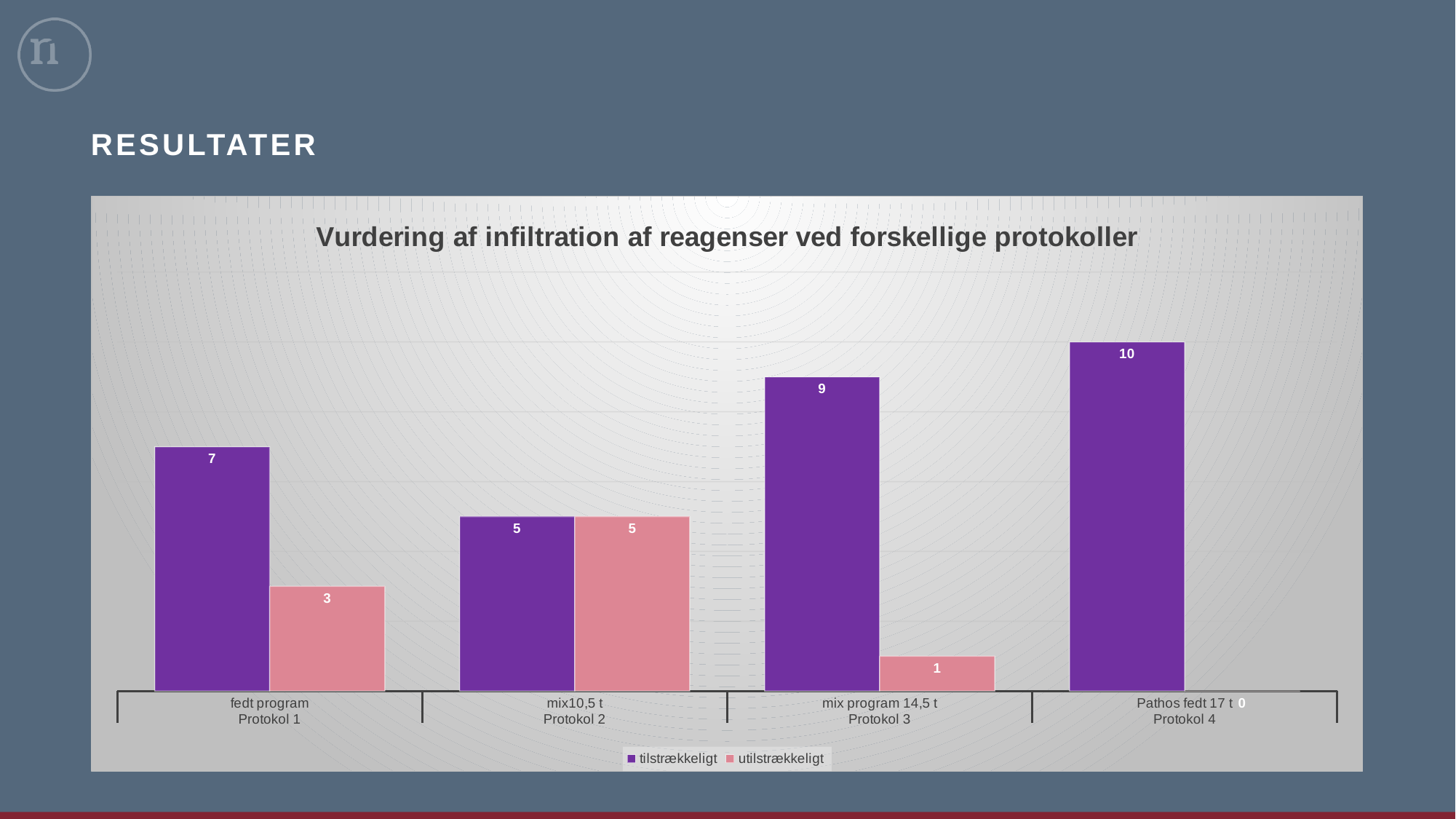
What is the value of utilstrækkeligt for Protokol 3 (mix program 14,5 t)? 1 What is the total of tilstrækkeligt and utilstrækkeligt for Protokol 2? 10 How many series does the legend list? 2 How many protocols are shown on the x axis? 4 What is the difference between the tilstrækkeligt and utilstrækkeligt values for Protokol 1? 4 What is the title of the chart? Vurdering af infiltration af reagenser ved forskellige protokoller Which protocol has the highest tilstrækkeligt value? Protokol 4 (Pathos fedt 17 t) Which protocol has the lowest tilstrækkeligt value? Protokol 2 (mix10,5 t) What kind of chart is shown? bar chart What is the value of utilstrækkeligt for Protokol 4 (Pathos fedt 17 t)? 0 What is the value of tilstrækkeligt for Protokol 1 (fedt program)? 7 Which is larger for Protokol 3: tilstrækkeligt or utilstrækkeligt? tilstrækkeligt